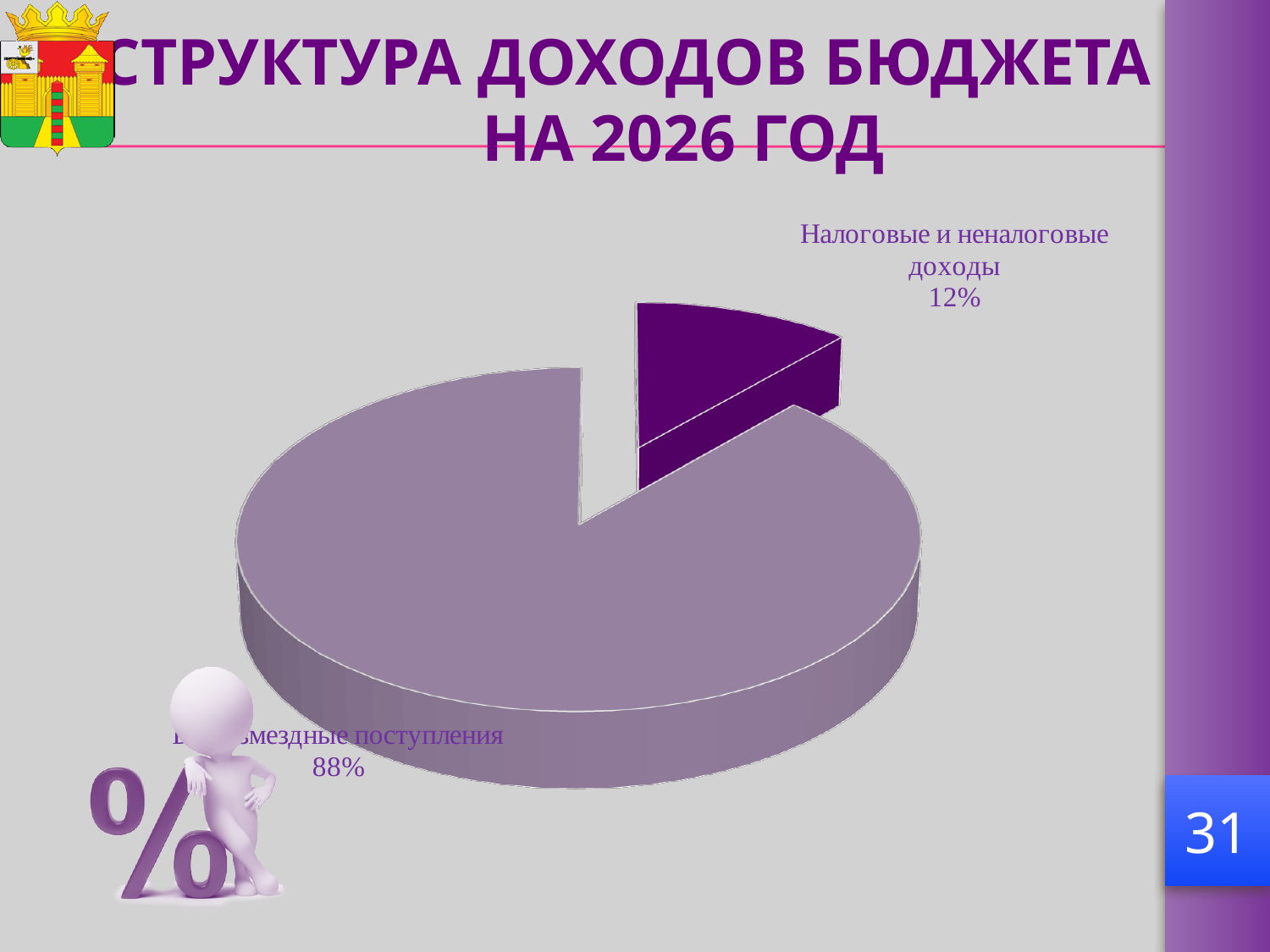
How many slices does the pie chart have? 2 Which is larger: the share of "Налоговые и неналоговые доходы" or the share of "Безвозмездные поступления"? Безвозмездные поступления What kind of chart is shown on the slide? Pie chart What share of the pie does "Налоговые и неналоговые доходы" represent? 12% What is the difference in percentage points between the 88% slice and the "Налоговые и неналоговые доходы" slice? 76 What is the title of the slide containing the pie chart? СТРУКТУРА ДОХОДОВ БЮДЖЕТА НА 2026 ГОД What share of the pie does the larger slice ("Безвозмездные поступления") represent? 88% What is the total of the two slice percentages shown on the pie chart? 100% Which slice of the pie is the smallest? Налоговые и неналоговые доходы Which slice of the pie is the largest? Безвозмездные поступления What colour is the "Налоговые и неналоговые доходы" slice of the pie? Dark purple